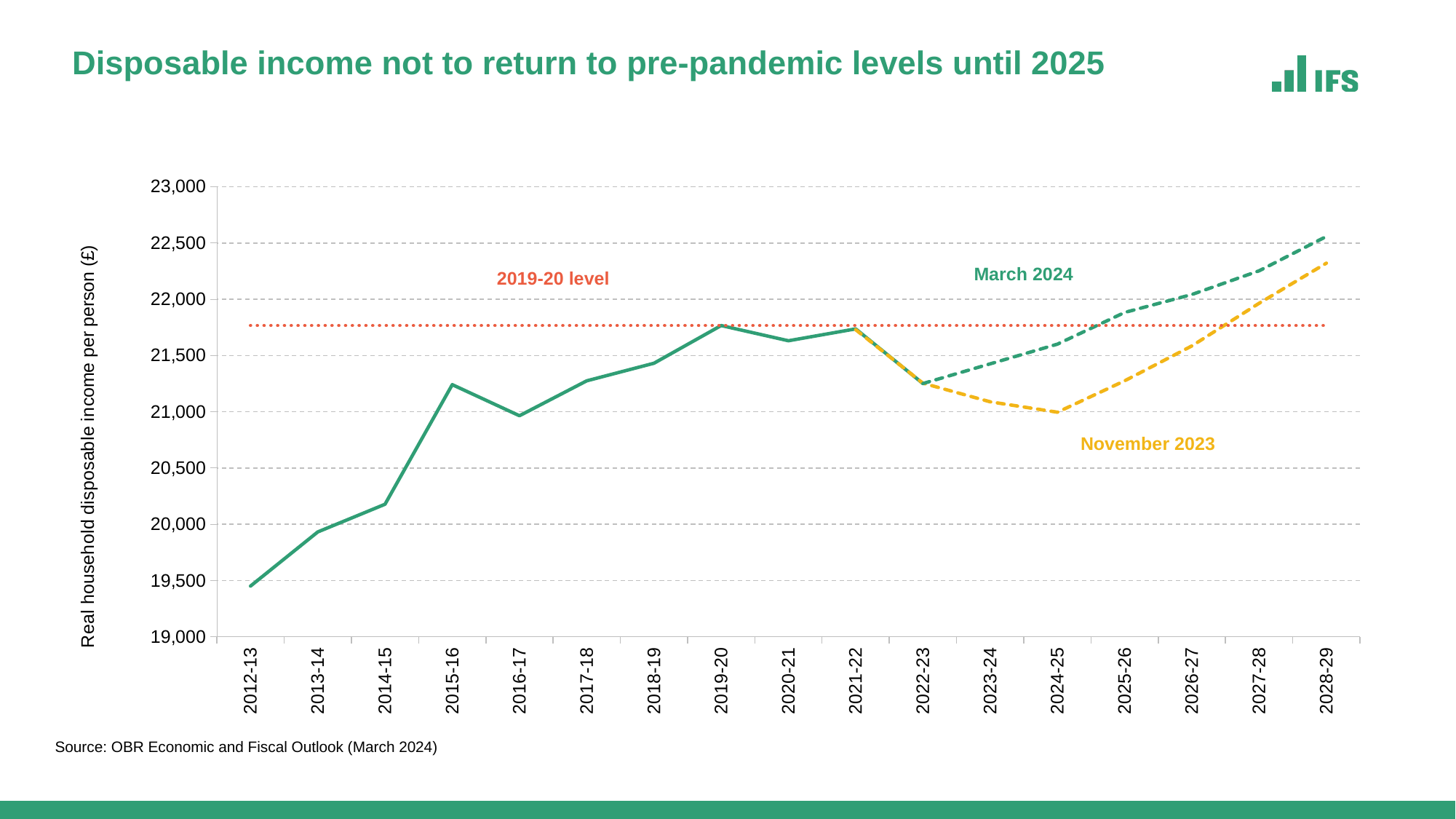
Is the March 2024 forecast value for 2025-26 greater or less than 21,500? greater Is the value for 2014-15 greater or less than 20,000? greater Is the value for 2015-16 greater or less than 21,000? greater In 2024-25, which forecast is higher, March 2024 or November 2023? March 2024 What does the horizontal red dotted line on the chart represent? 2019-20 level How many financial years are shown on the x axis? 17 What kind of chart is shown on the slide? line chart Which is larger, the value for 2019-20 or the value for 2016-17? 2019-20 Which year has the lowest real household disposable income per person on the chart? 2012-13 Does real household disposable income per person rise or fall from 2012-13 to 2015-16? rise